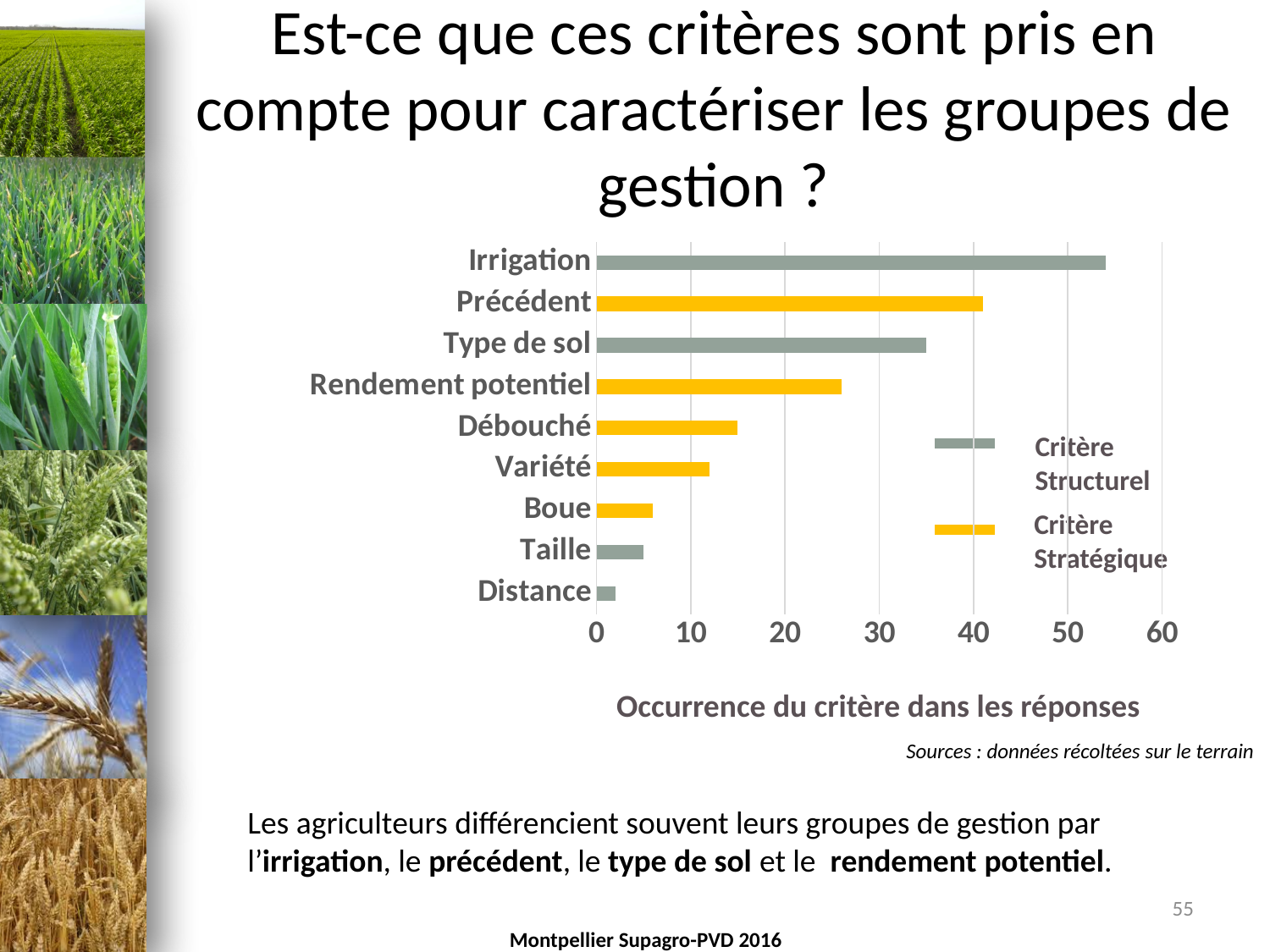
Which has a higher occurrence, Débouché or Variété? Débouché What kind of chart is shown on the slide? bar chart Is the value for Irrigation greater or less than 50? greater Which has a higher occurrence, Précédent or Type de sol? Précédent Is the value for Type de sol greater or less than 40? less Is the value for Débouché greater or less than 20? less How many series does the chart legend list? 2 Which criterion has the highest occurrence in the chart? Irrigation How many criteria (categories) are plotted in the chart? 9 What is the label of the horizontal axis of the chart? Occurrence du critère dans les réponses Which criterion has the lowest occurrence in the chart? Distance